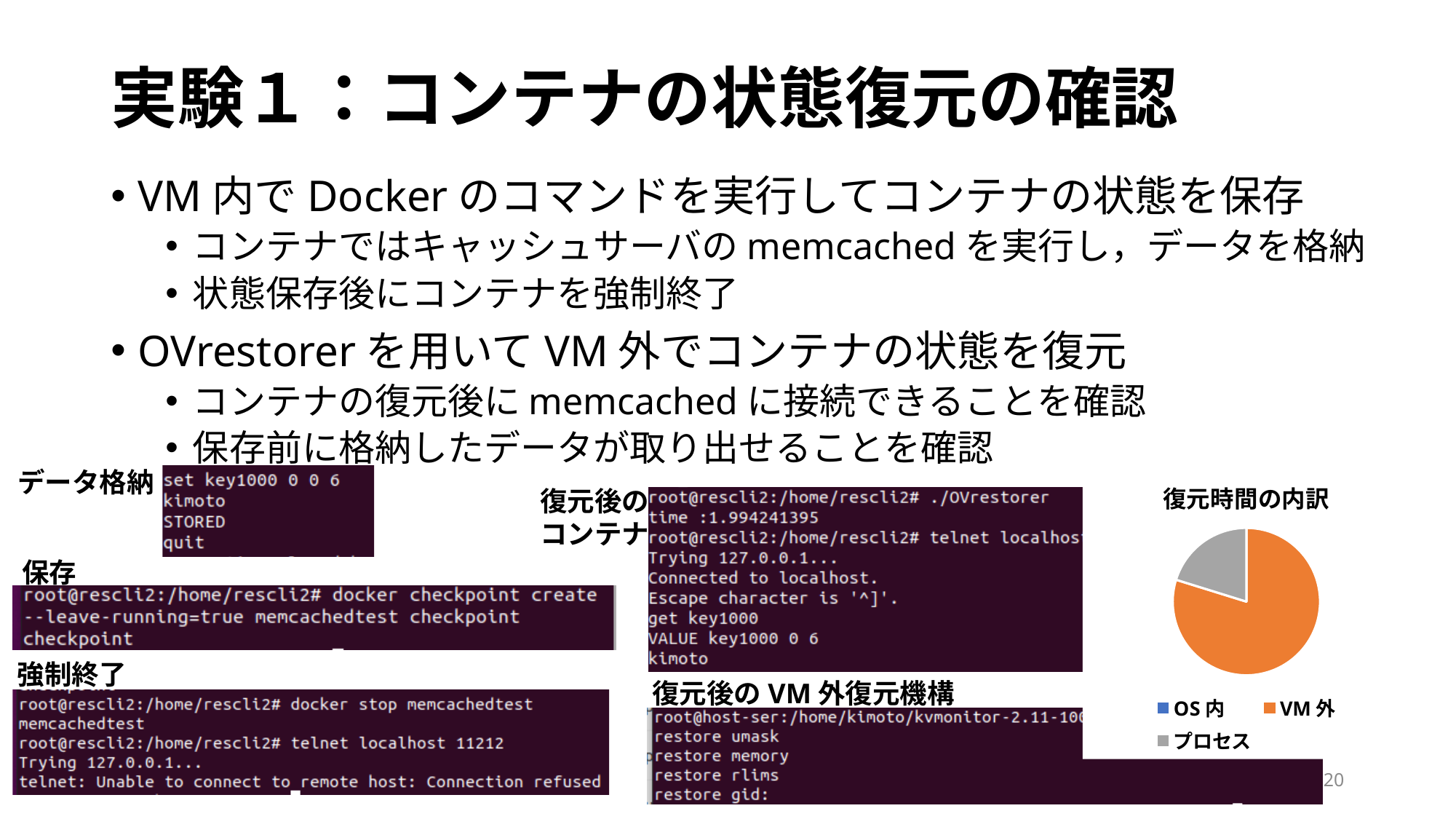
Which category takes up the largest share of the pie chart? VM 外 Which is larger in the pie chart, VM 外 or プロセス? VM 外 Which legend entry is shown in gray in the pie chart? プロセス How many entries does the legend of the pie chart list? 3 What is the title of the pie chart? 復元時間の内訳 Is the share of VM 外 in the pie chart greater or less than half of the pie? greater How many categories are shown in the pie chart's legend? 3 What colour represents VM 外 in the pie chart? orange What kind of chart is shown on the slide? pie chart